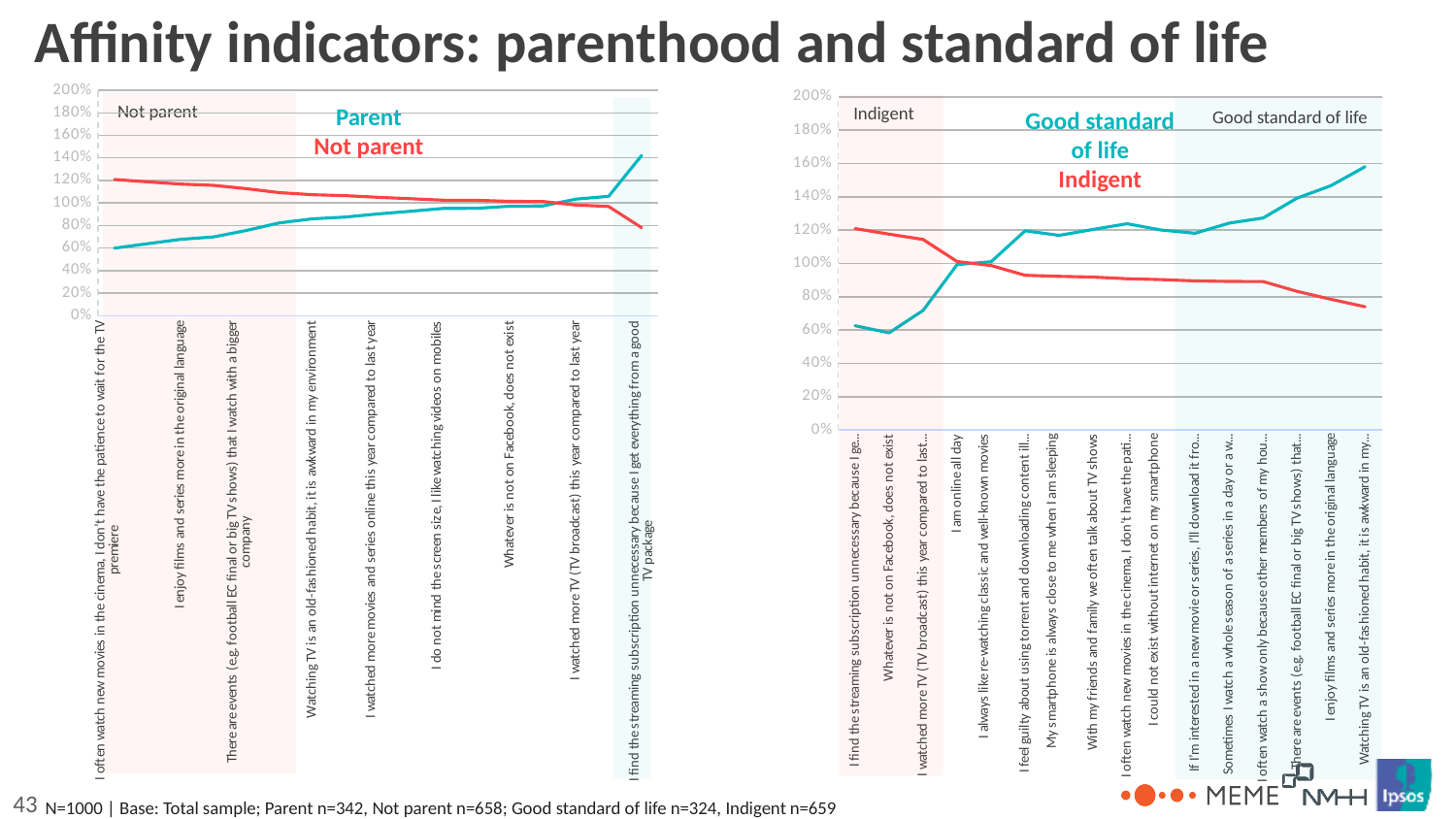
How many categories are plotted along the x axis of the right chart? 16 On the left chart, does the Parent line rise or fall from left to right along the x axis? Rise On the right chart, does the Indigent line rise or fall from left to right along the x axis? Fall What kind of chart is the left chart on the slide? Line chart On the left chart, for "I enjoy films and series more in the original language", which series has the higher value, Parent or Not parent? Not parent On the left chart, is the Not parent value for "I find the streaming subscription unnecessary because I get everything from a good TV package" greater or less than 100%? less On the left chart, is the Parent value for "I often watch new movies in the cinema, I don't have the patience to wait for the TV premiere" greater or less than 80%? less On the right chart, is the Good standard of life value for "Whatever is not on Facebook, does not exist" greater or less than 80%? less On the right chart, for which category is the Good standard of life line at its highest? Watching TV is an old-fashioned habit, it is awkward in my...